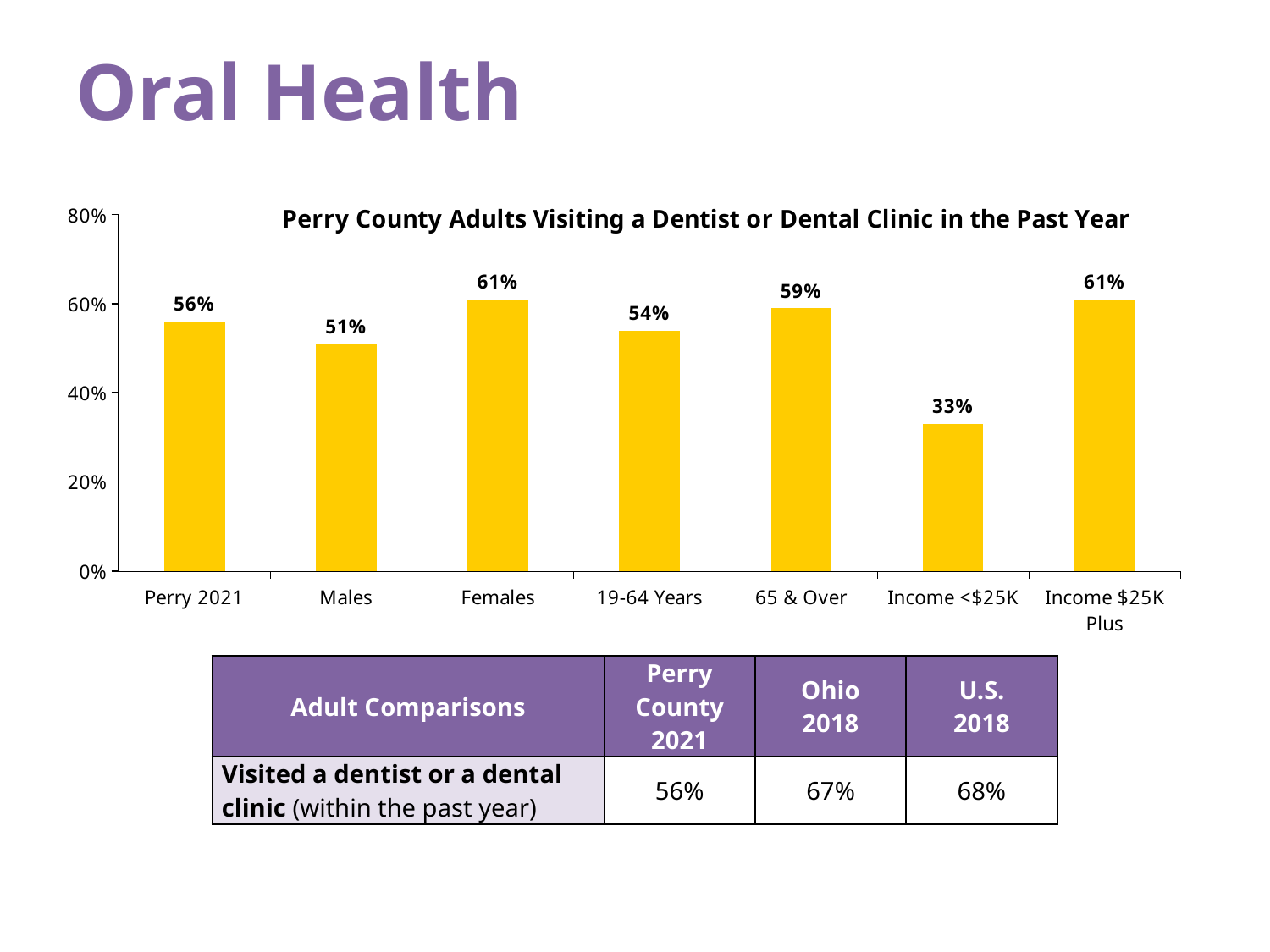
What is the highest value shown on the y axis of the chart? 80% Which is larger, the value for 65 & Over or the value for 19-64 Years? 65 & Over What is the difference between the values for Females and Males? 10% What kind of chart is shown on the slide? Bar chart What percentage of Perry County males visited a dentist or dental clinic in the past year? 51% Is the value for Perry 2021 greater or less than 40%? greater What is the title of the chart? Perry County Adults Visiting a Dentist or Dental Clinic in the Past Year How many categories are shown on the x axis of the chart? 7 Which category has the lowest value in the chart? Income <$25K What is the value shown for the Income <$25K category? 33% What is the difference between the Income $25K Plus and Income <$25K values? 28% What is the value for the 65 & Over category? 59%